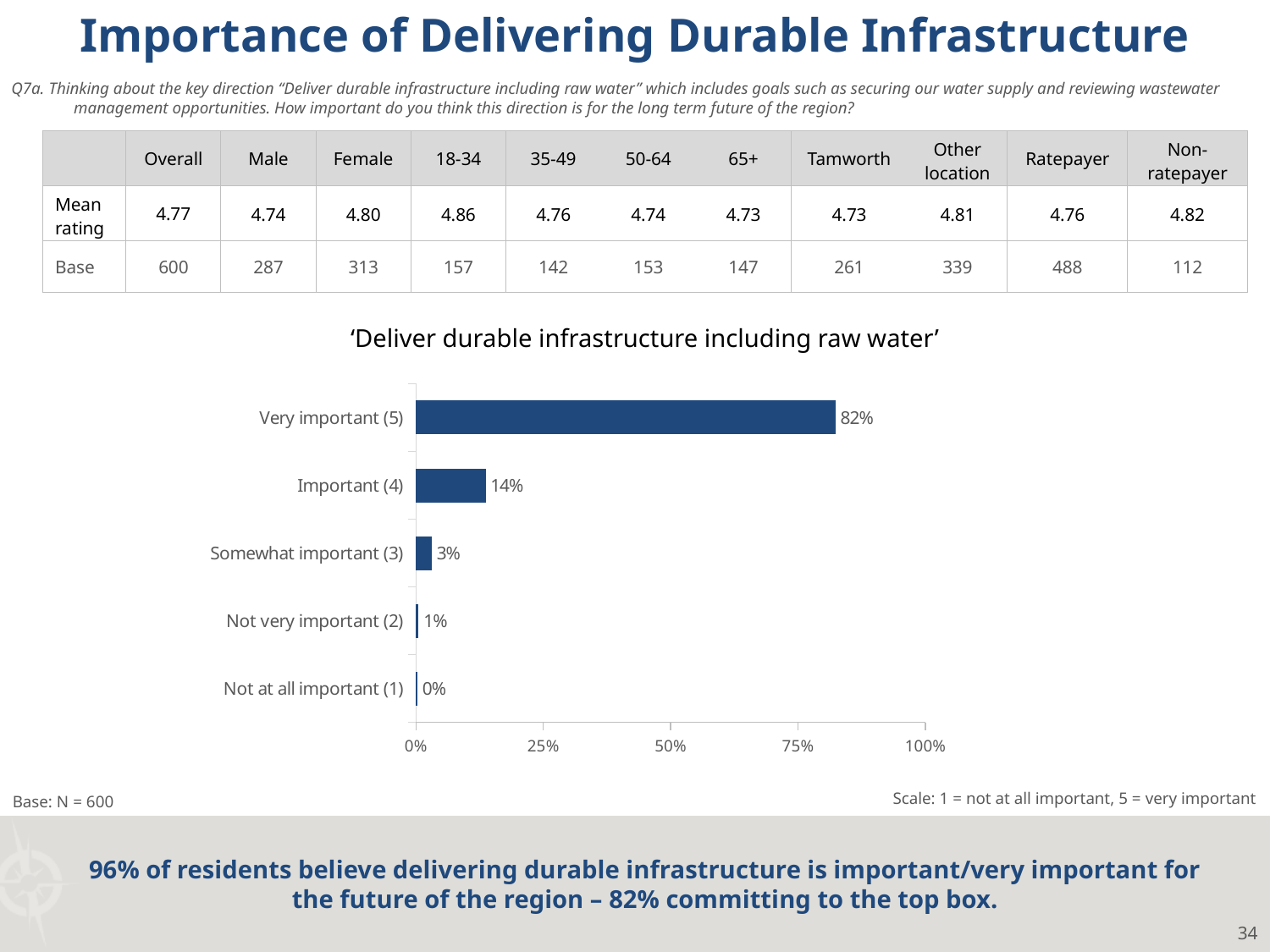
What percentage of respondents rated the direction as 'Important (4)'? 14% What type of chart is shown on the slide? Bar chart What percentage of respondents rated the direction as 'Somewhat important (3)'? 3% How many rating categories are shown in the chart? 5 What is the title of the chart? 'Deliver durable infrastructure including raw water' Is the value for 'Very important (5)' greater or less than 75%? greater Which rating category has the highest percentage? Very important (5) What percentage of respondents rated the direction as 'Not very important (2)'? 1% What is the difference in percentage points between 'Very important (5)' and 'Important (4)'? 68 Which rating category has the lowest percentage? Not at all important (1) Which is larger: the percentage for 'Important (4)' or for 'Somewhat important (3)'? Important (4) What percentage of respondents rated the direction as 'Very important (5)'? 82%